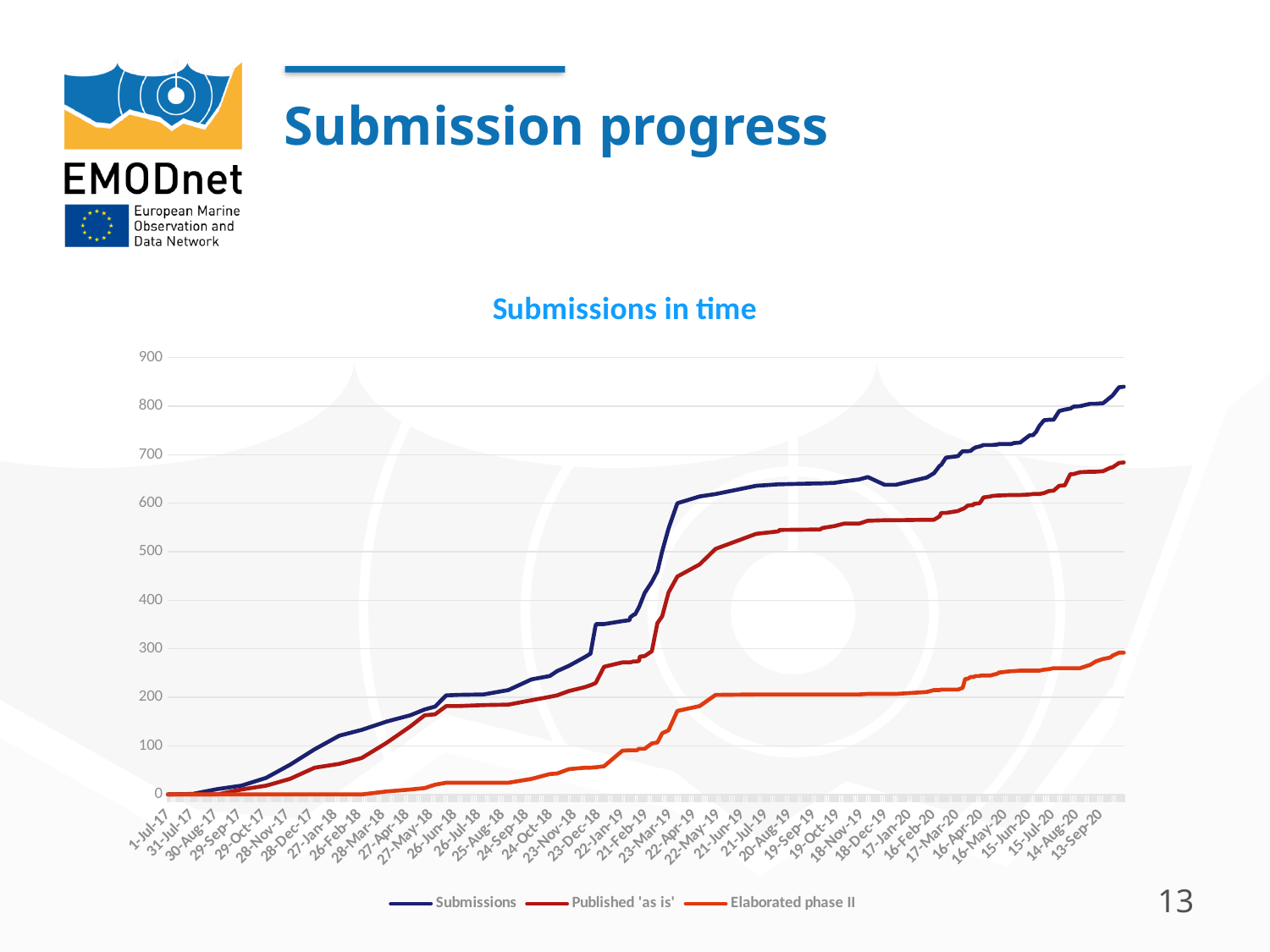
Which series has the lowest value at the last date, 13-Sep-20? Elaborated phase II What is the value of the Submissions series at 1-Jul-17? 0 Is the value of the Elaborated phase II series at 13-Sep-20 greater or less than 400? less What is the title of the chart? Submissions in time At 13-Sep-20, which is larger: the Submissions value or the Published 'as is' value? Submissions Which series is drawn in orange in the chart? Elaborated phase II Do the values of the Submissions series rise or fall along the x axis? rise Which series has the highest value at the last date, 13-Sep-20? Submissions Is the value of the Published 'as is' series at 13-Sep-20 greater or less than 700? less What kind of chart is shown on the slide? line chart How many series does the legend of the chart list? 3